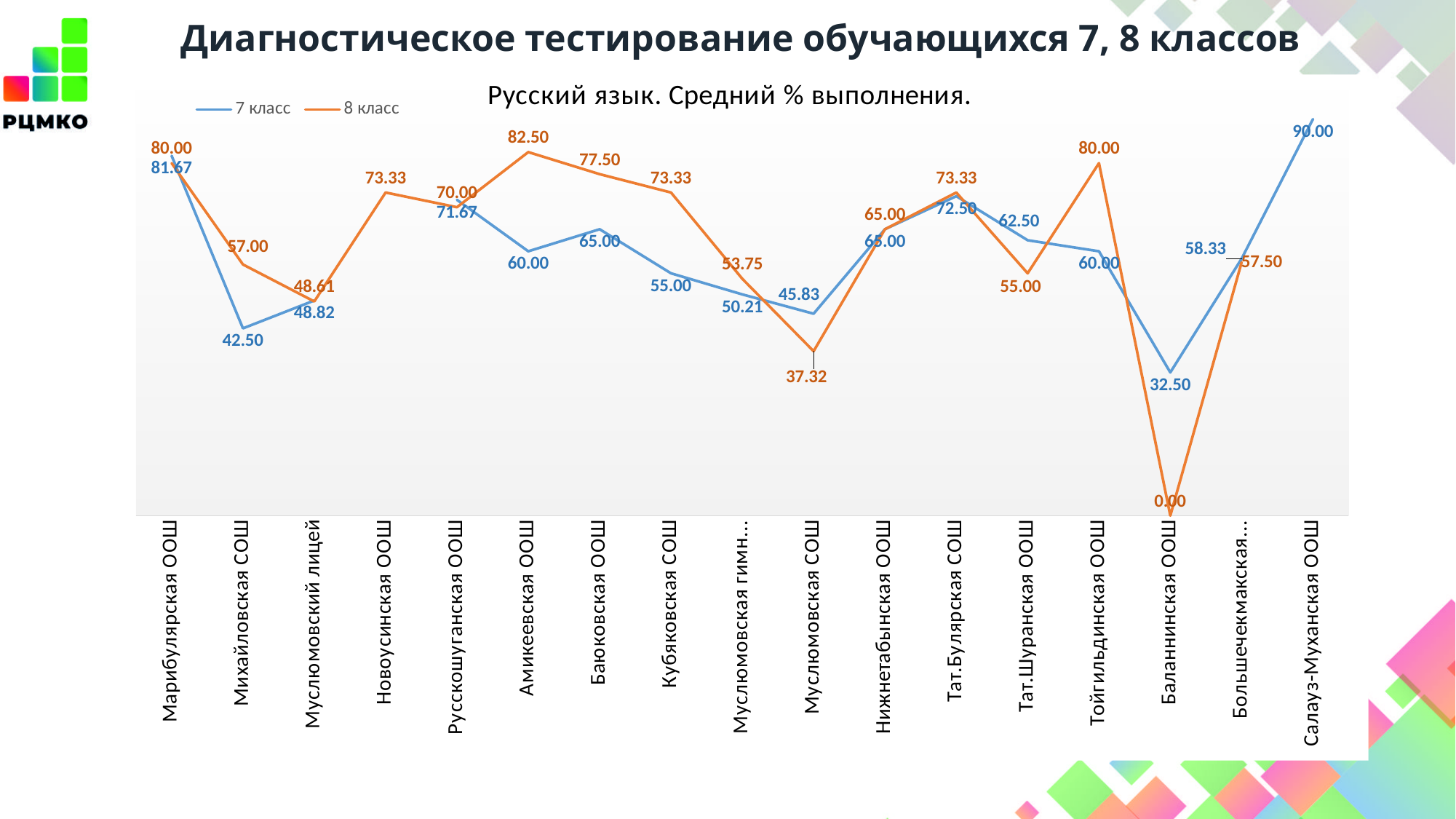
What is the difference between the 8 класс and 7 класс values at Амикеевская ООШ? 22.50 What is the value for 7 класс at Амикеевская ООШ? 60.00 What is the title of the chart? Русский язык. Средний % выполнения. What is the value for 8 класс at Муслюмовская СОШ? 37.32 Which school has the lowest value for 8 класс? Баланнинская ООШ At Муслюмовская СОШ, which series has the larger value, 7 класс or 8 класс? 7 класс How many series does the legend list? 2 What is the difference between the 8 класс and 7 класс values at Тойгильдинская ООШ? 20.00 What kind of chart is shown on the slide? Line chart Which school has the highest value for 7 класс? Салауз-Муханская ООШ What is the value for 8 класс at Тойгильдинская ООШ? 80.00 How many schools are shown along the x axis? 17